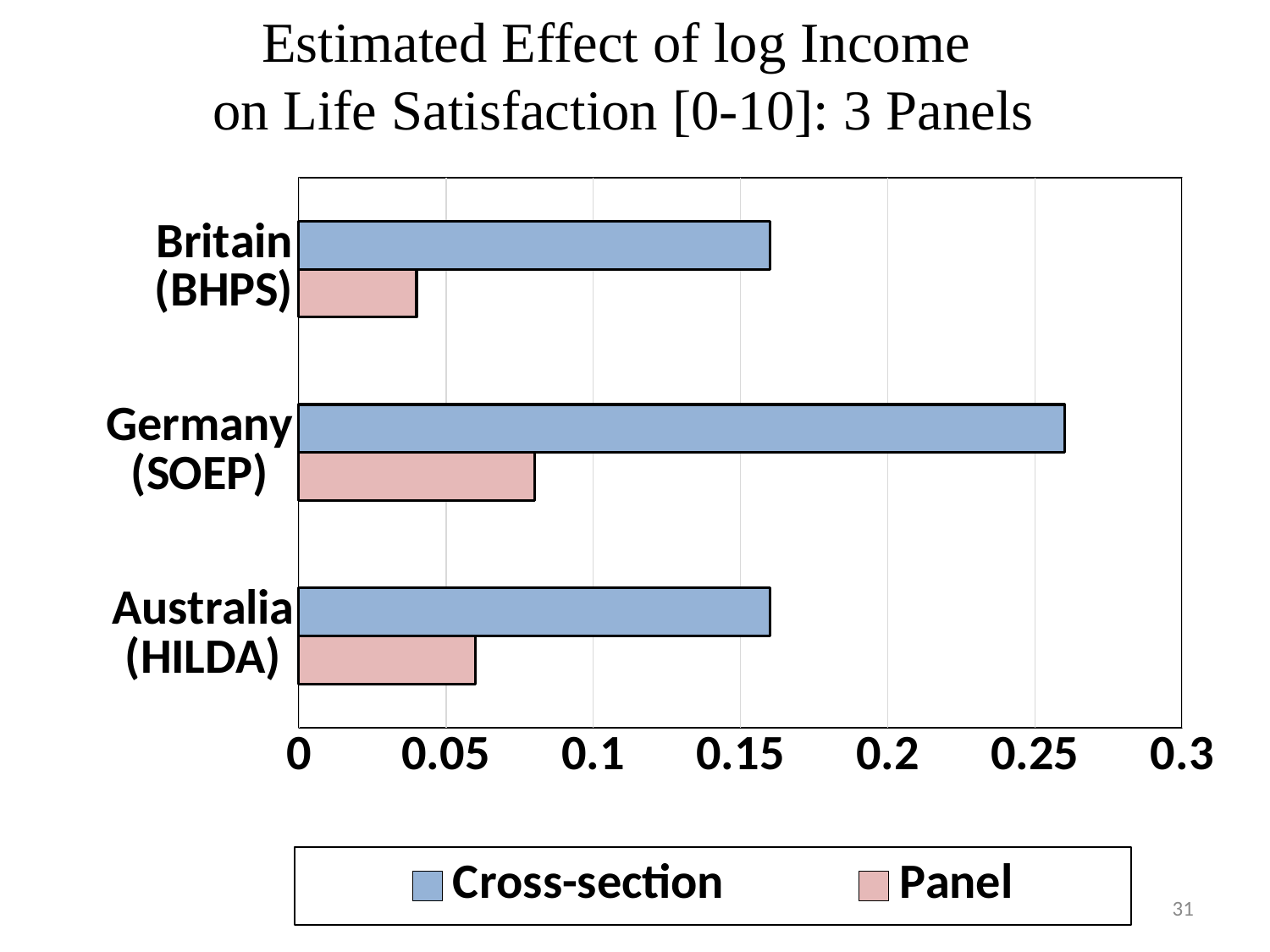
What is the title of the chart? Estimated Effect of log Income on Life Satisfaction [0-10]: 3 Panels Which country has the lowest Panel value? Britain (BHPS) How many series does the legend list? 2 Is the Cross-section value for Britain (BHPS) greater or less than 0.1? greater Which country has the highest Cross-section value? Germany (SOEP) Is the Panel value for Britain (BHPS) greater or less than 0.05? less Is the Cross-section value for Australia (HILDA) greater or less than 0.2? less How many countries (categories) are shown on the chart? 3 What kind of chart is shown on the slide? bar chart Which country has the highest Panel value? Germany (SOEP) For Germany (SOEP), which is larger: the Cross-section value or the Panel value? Cross-section